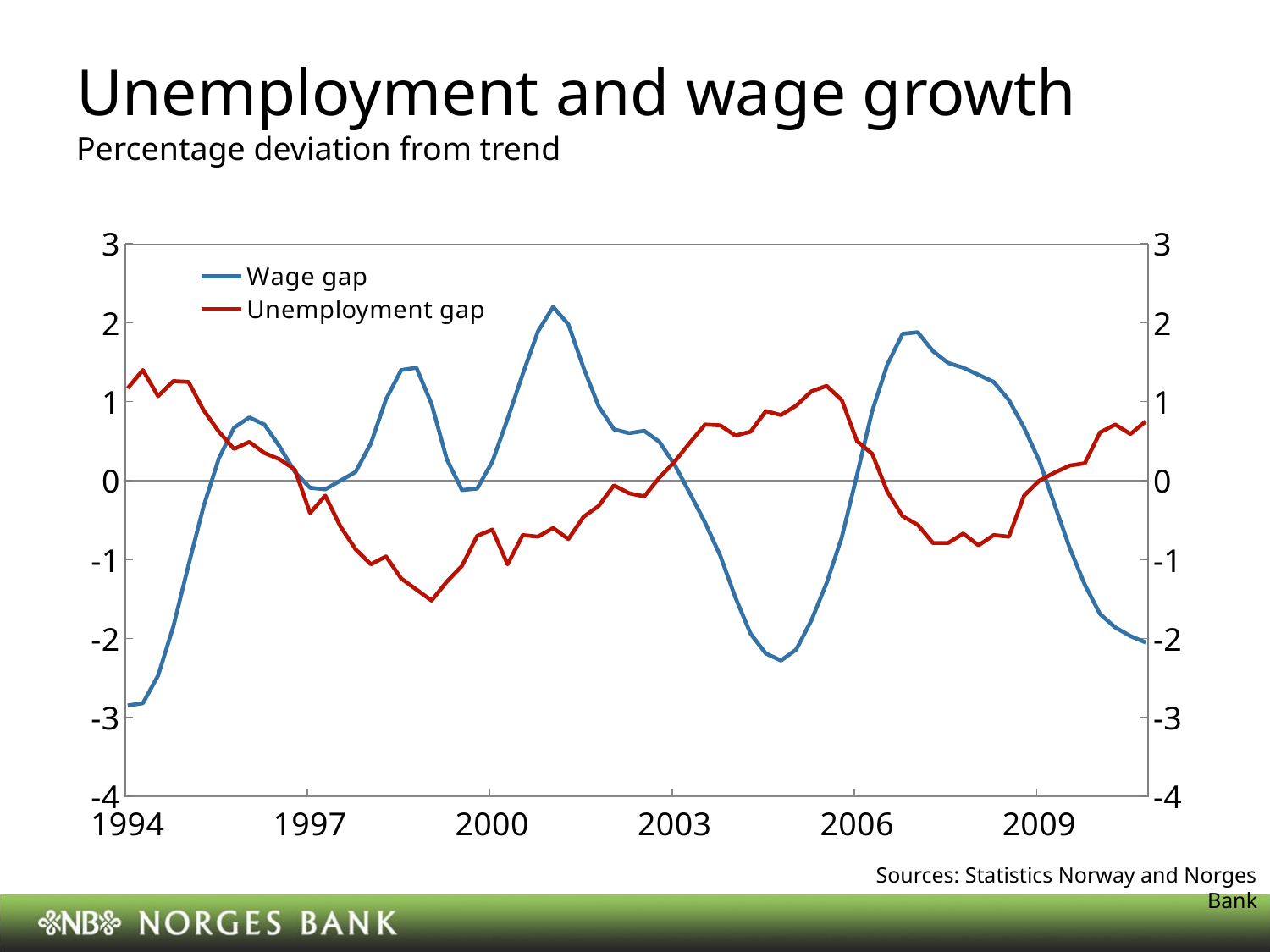
What kind of chart is shown on the slide? Line chart Which colour is used for the Unemployment gap line? Red Is the Unemployment gap value at 1994 greater or less than 1? greater Which series reaches the highest value anywhere on the chart? Wage gap Is the peak of the Wage gap around 2001 greater or less than 2? greater Around 2001, which series has the higher value, Wage gap or Unemployment gap? Wage gap Is the Wage gap value at 1994 greater or less than -2? less At 1994, which series has the higher value, Wage gap or Unemployment gap? Unemployment gap How many series does the legend list? 2 What is the title of the chart? Unemployment and wage growth Does the Wage gap rise or fall from 2007 to the end of the series? Fall